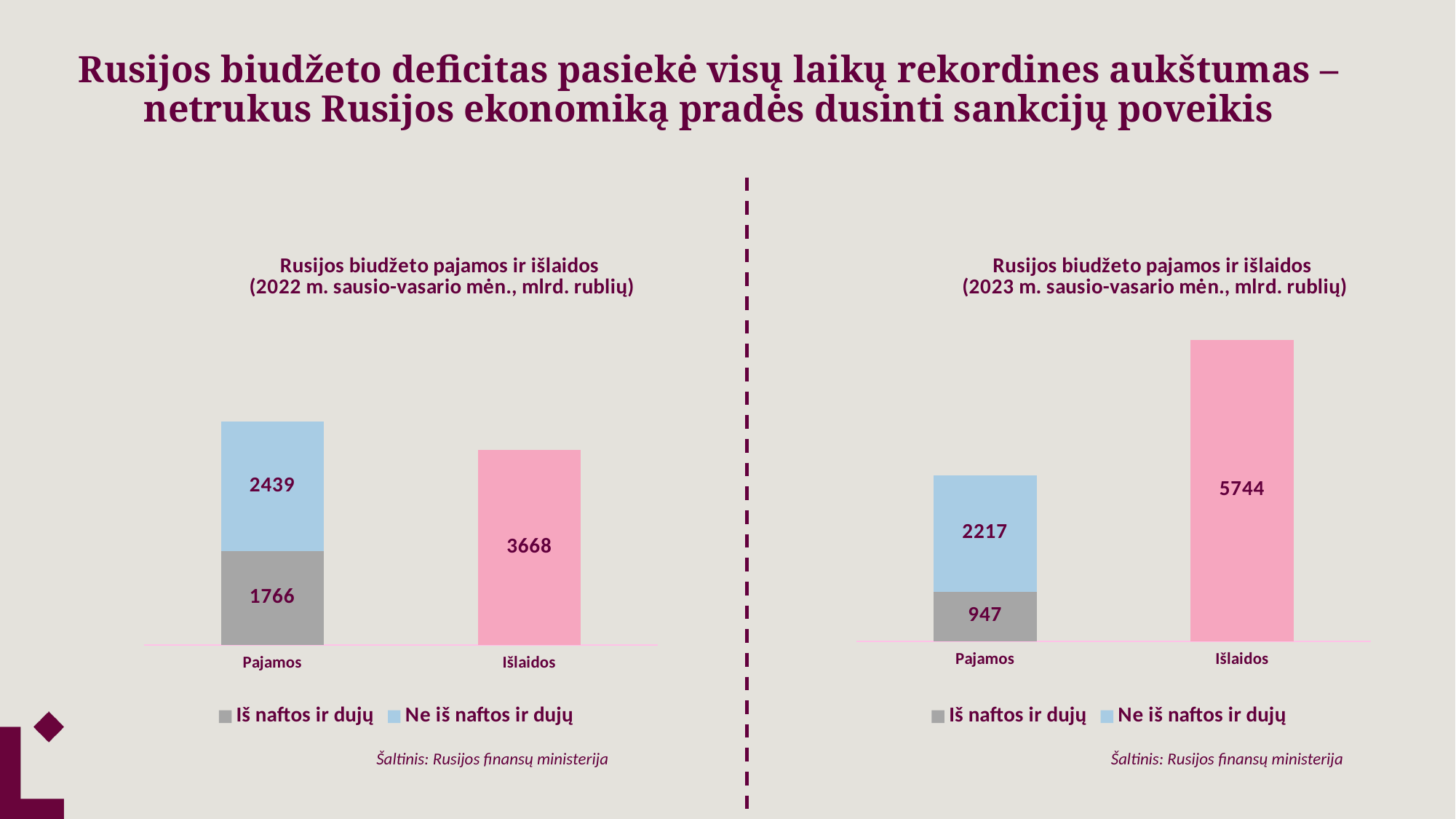
What kind of chart is the left chart (2022 m. sausio-vasario mėn.)? Bar chart How many series does the legend of the right chart (2023 m. sausio-vasario mėn.) list? 2 In the left chart (2022 m. sausio-vasario mėn.), what is the value shown for Išlaidos? 3668 In the right chart (2023 m. sausio-vasario mėn.), what is the difference between Išlaidos and the 'Ne iš naftos ir dujų' part of Pajamos? 3527 In the right chart (2023 m. sausio-vasario mėn.), what is the value shown for Išlaidos? 5744 In the right chart (2023 m. sausio-vasario mėn.), what is the total of the stacked Pajamos bar? 3164 In the left chart (2022 m. sausio-vasario mėn.), what is the total of the stacked Pajamos bar? 4205 In the left chart (2022 m. sausio-vasario mėn.), what is the value of 'Ne iš naftos ir dujų' for Pajamos? 2439 In the left chart (2022 m. sausio-vasario mėn.), what is the value of 'Iš naftos ir dujų' for Pajamos? 1766 In the left chart (2022 m. sausio-vasario mėn.), which is larger: the 'Iš naftos ir dujų' part of Pajamos or the 'Ne iš naftos ir dujų' part? Ne iš naftos ir dujų In the right chart (2023 m. sausio-vasario mėn.), what is the value of 'Ne iš naftos ir dujų' for Pajamos? 2217 In the right chart (2023 m. sausio-vasario mėn.), what is the value of 'Iš naftos ir dujų' for Pajamos? 947